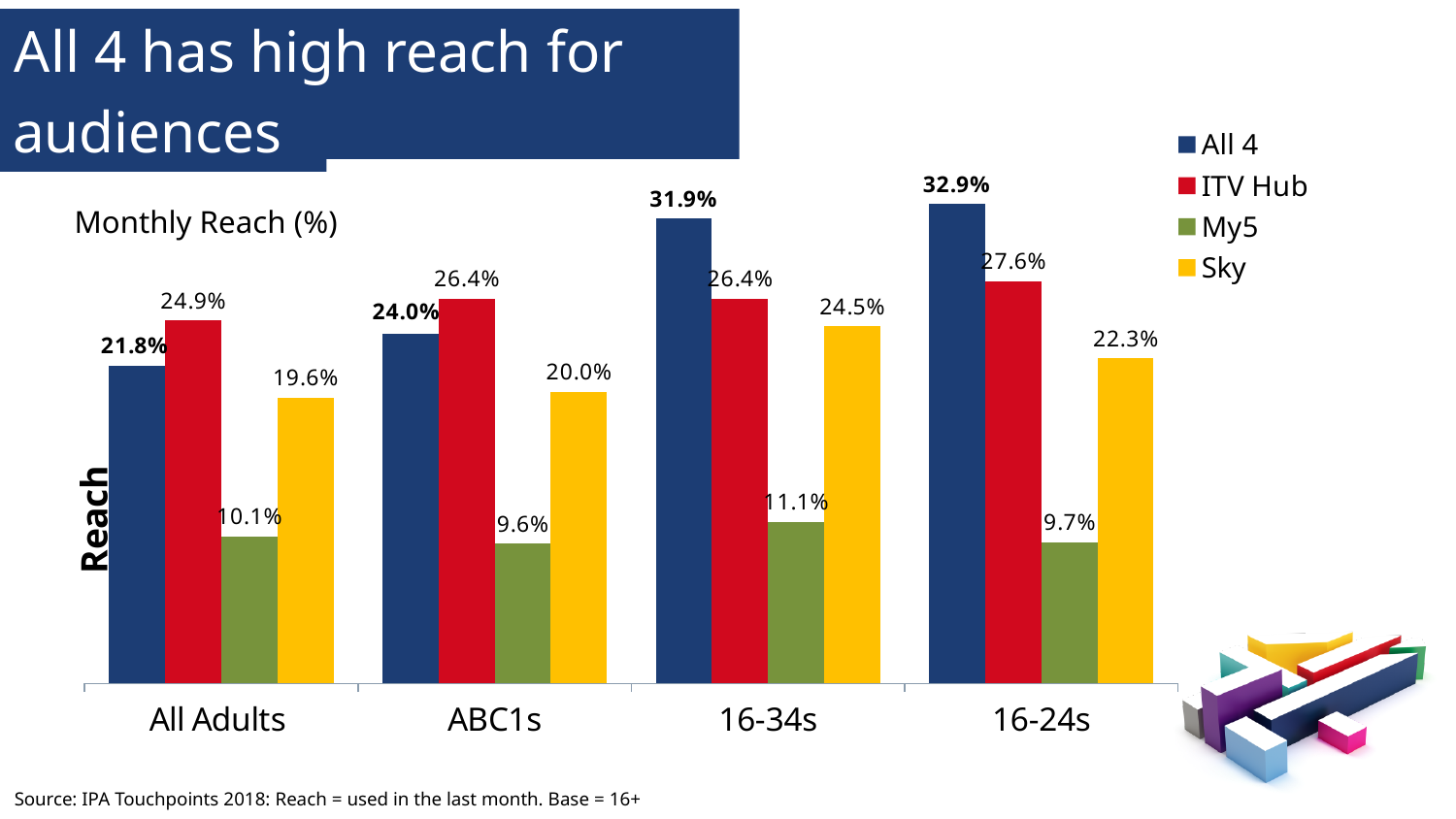
What is the monthly reach for ITV Hub among All Adults? 24.9% What is the monthly reach for All 4 among 16-24s? 32.9% Which colour represents Sky in the chart? Yellow Among All Adults, which has the higher monthly reach, All 4 or ITV Hub? ITV Hub What is the monthly reach for Sky among 16-34s? 24.5% Which audience group has the highest monthly reach for All 4? 16-24s How many series does the legend list? 4 What kind of chart is shown on the slide? Bar chart How many audience groups are shown on the x axis? 4 What is the difference between the All 4 and ITV Hub monthly reach among 16-34s? 5.5% What is the monthly reach for My5 among ABC1s? 9.6% Which service has the lowest monthly reach among 16-24s? My5